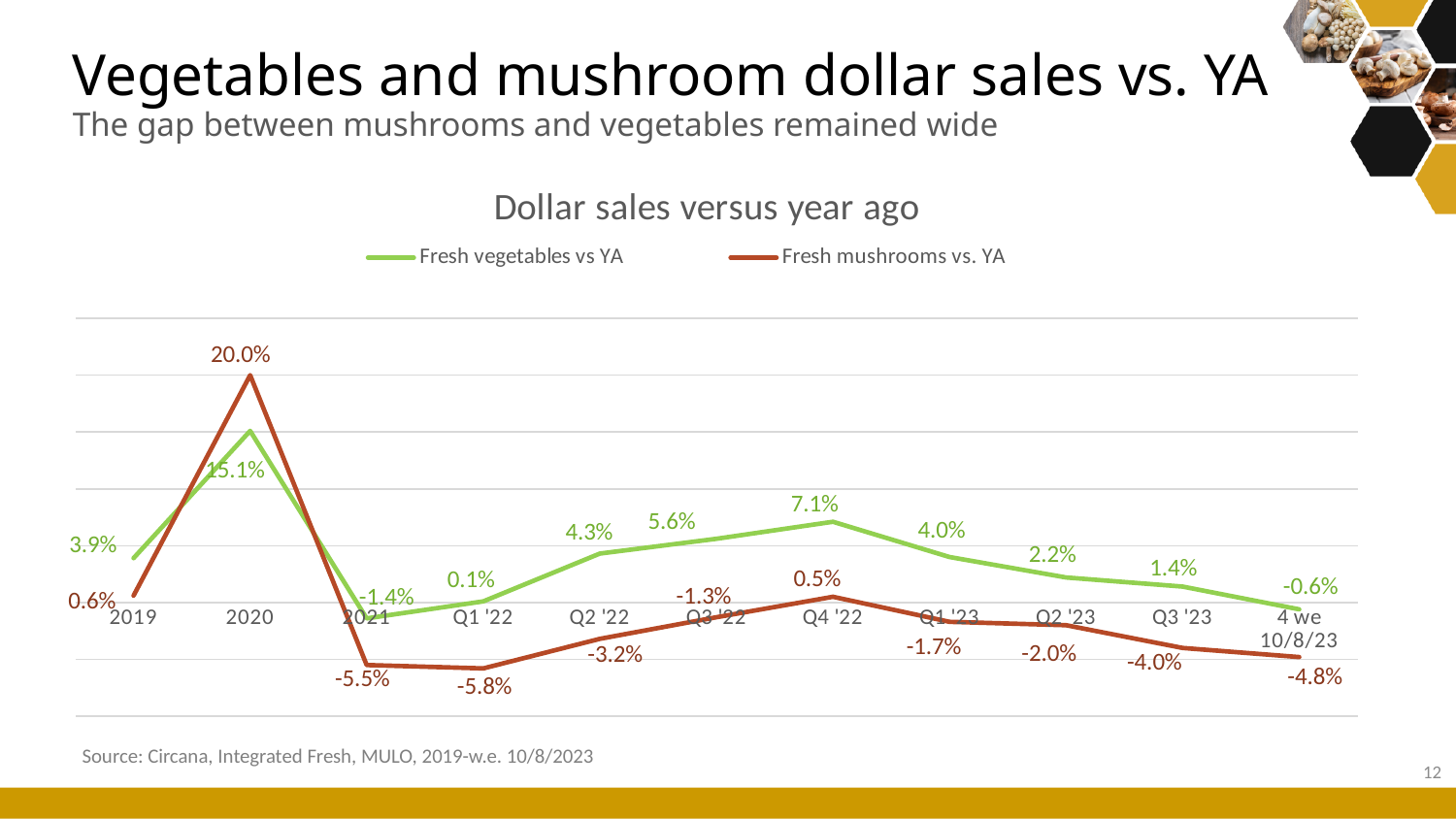
In which period is Fresh mushrooms vs. YA at its highest? 2020 What is the difference between Fresh vegetables vs YA and Fresh mushrooms vs. YA in Q4 '22? 6.6 percentage points What kind of chart is shown? Line chart How many series does the legend list? 2 What is the value for Fresh mushrooms vs. YA for the 4 we 10/8/23 period? -4.8% In which period is Fresh vegetables vs YA at its lowest? 2021 What is the value for Fresh vegetables vs YA in Q4 '22? 7.1% How many periods are shown on the x axis? 11 What is the value for Fresh mushrooms vs. YA in 2020? 20.0% In 2020, which series has the higher value, Fresh vegetables vs YA or Fresh mushrooms vs. YA? Fresh mushrooms vs. YA From Q4 '22 to 4 we 10/8/23, does Fresh vegetables vs YA rise or fall? Fall In which period is Fresh mushrooms vs. YA at its lowest? Q1 '22